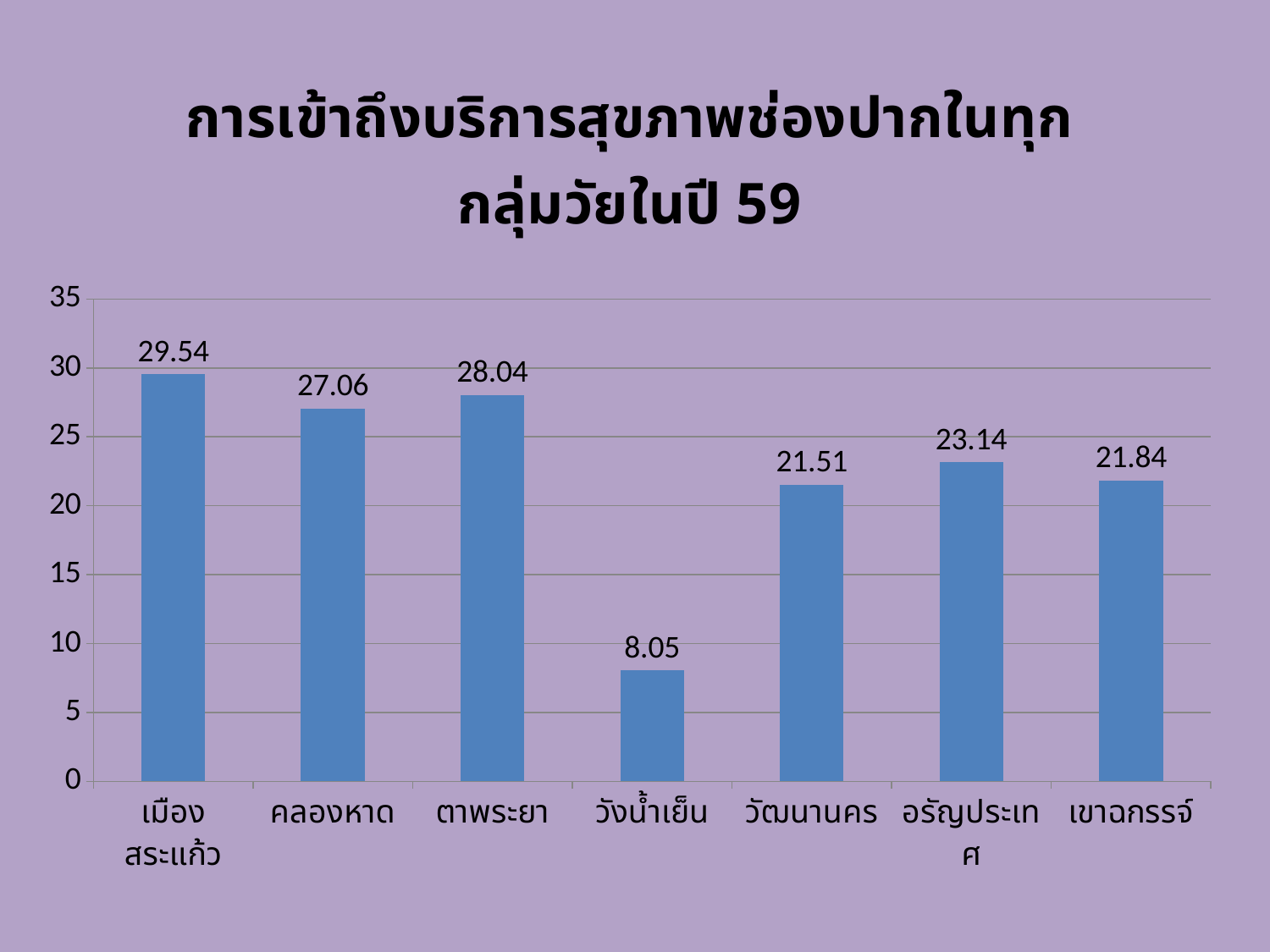
What is the value for วังน้ำเย็น? 8.05 What is the difference between the values for ตาพระยา and คลองหาด? 0.98 Which category has the lowest value? วังน้ำเย็น Is the value for เขาฉกรรจ์ greater or less than 20? greater What is the title of the chart? การเข้าถึงบริการสุขภาพช่องปากในทุกกลุ่มวัยในปี 59 How many categories are shown on the x axis? 7 What is the difference between the values for เมืองสระแก้ว and วังน้ำเย็น? 21.49 What is the value for อรัญประเทศ? 23.14 Which is larger, the value for คลองหาด or the value for วัฒนานคร? คลองหาด What is the value for เมืองสระแก้ว? 29.54 What kind of chart is shown on the slide? bar chart Which category has the highest value? เมืองสระแก้ว